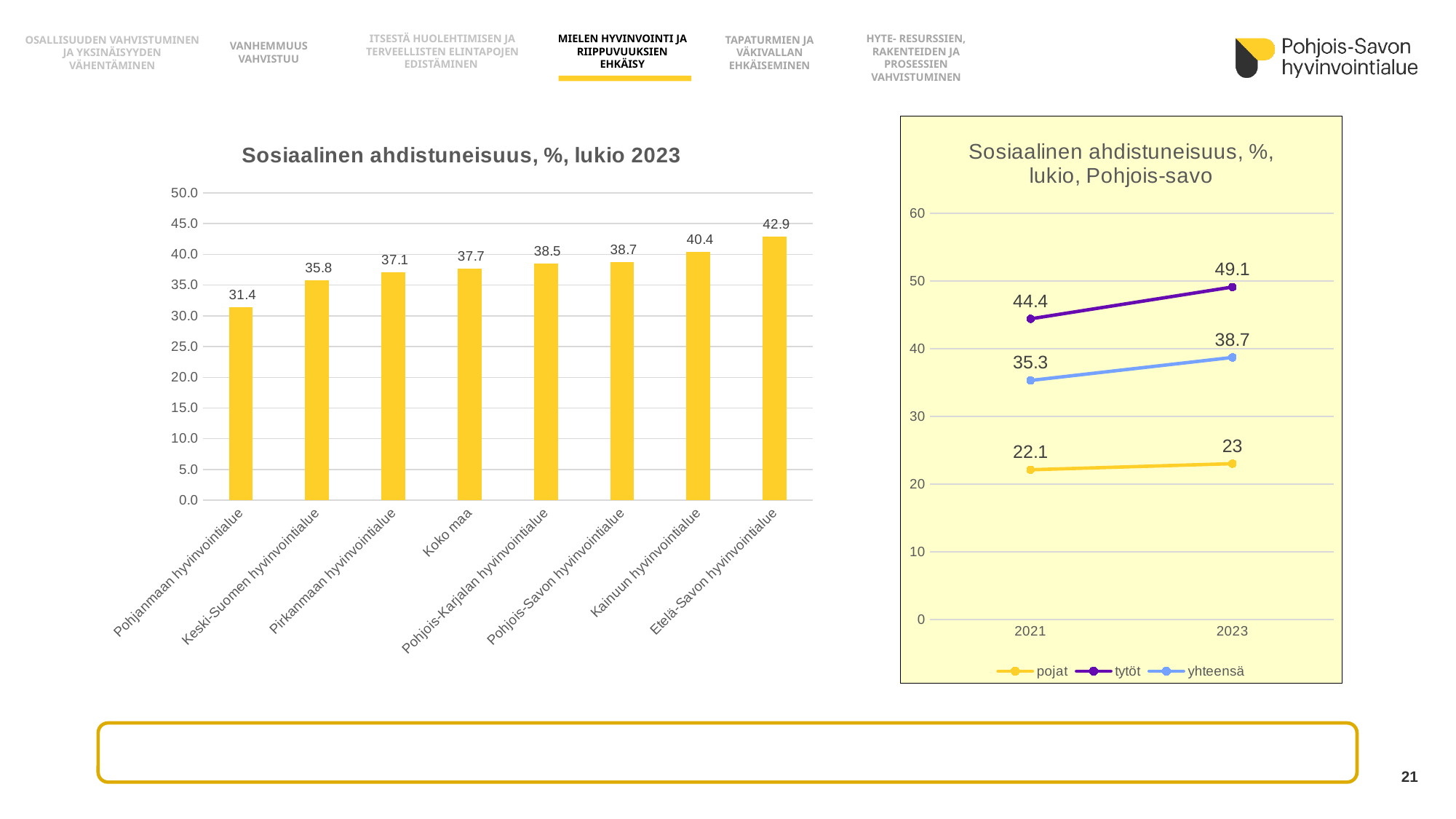
In the line chart 'Sosiaalinen ahdistuneisuus, %, lukio, Pohjois-savo', does the value for yhteensä rise or fall from 2021 to 2023? rise In the line chart 'Sosiaalinen ahdistuneisuus, %, lukio, Pohjois-savo', which is larger in 2021, tytöt or pojat? tytöt In the bar chart 'Sosiaalinen ahdistuneisuus, %, lukio 2023', what is the value for Pohjois-Savon hyvinvointialue? 38.7 In the line chart 'Sosiaalinen ahdistuneisuus, %, lukio, Pohjois-savo', how many series does the legend list? 3 What kind of chart is the left chart 'Sosiaalinen ahdistuneisuus, %, lukio 2023'? bar chart In the bar chart 'Sosiaalinen ahdistuneisuus, %, lukio 2023', how many categories are shown? 8 In the line chart 'Sosiaalinen ahdistuneisuus, %, lukio, Pohjois-savo', what is the value for tytöt in 2023? 49.1 In the bar chart 'Sosiaalinen ahdistuneisuus, %, lukio 2023', which category has the highest value? Etelä-Savon hyvinvointialue In the bar chart 'Sosiaalinen ahdistuneisuus, %, lukio 2023', which category has the lowest value? Pohjanmaan hyvinvointialue In the line chart 'Sosiaalinen ahdistuneisuus, %, lukio, Pohjois-savo', what is the value for pojat in 2021? 22.1 In the bar chart 'Sosiaalinen ahdistuneisuus, %, lukio 2023', what is the value for Koko maa? 37.7 In the bar chart 'Sosiaalinen ahdistuneisuus, %, lukio 2023', what is the difference between Etelä-Savon hyvinvointialue and Pohjanmaan hyvinvointialue? 11.5